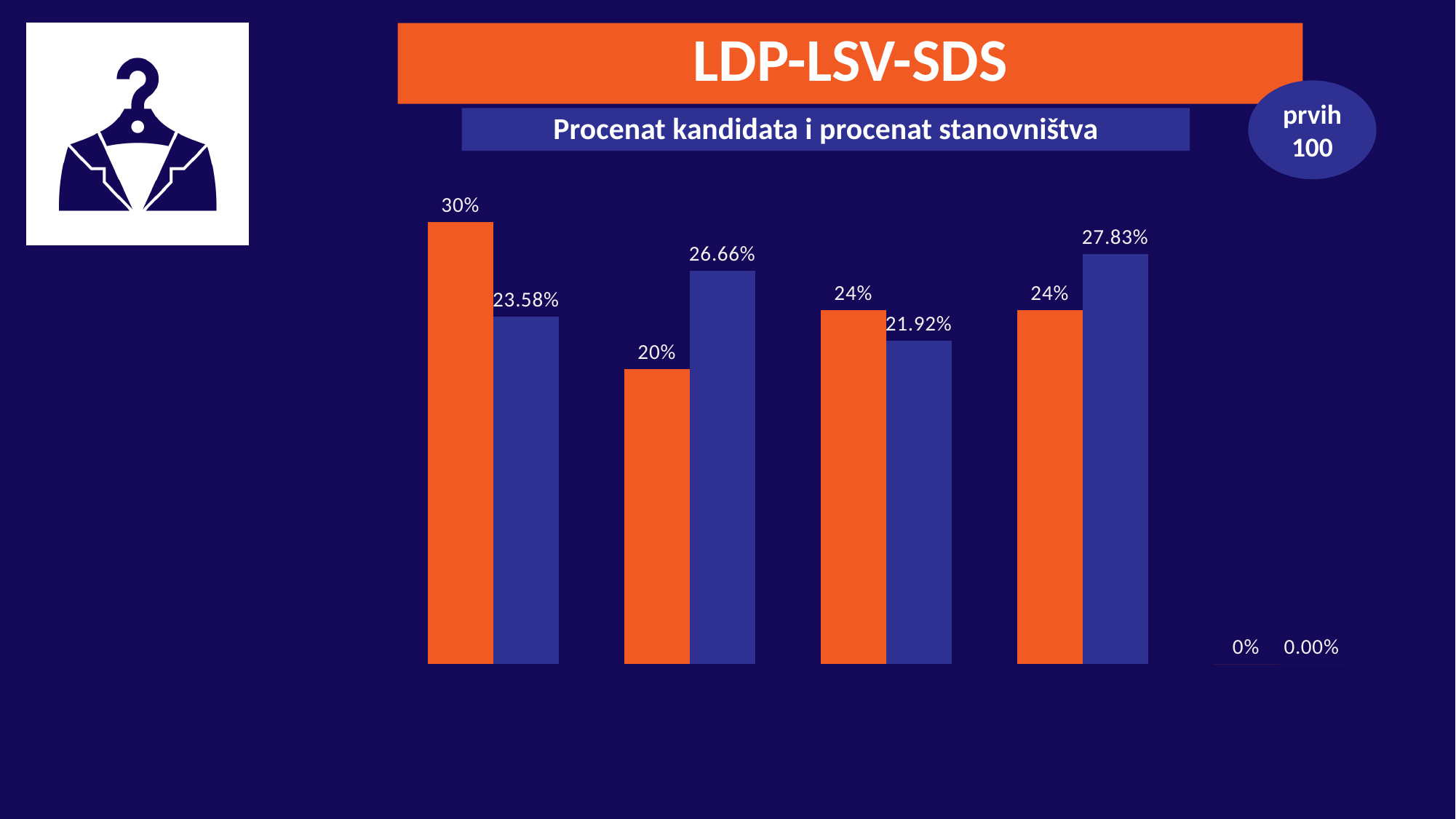
What kind of chart is shown on the slide? bar chart What is the value of the blue bar in the fourth group from the left? 27.83% What is the value of the orange bar in the first (leftmost) group? 30% How many orange bars have a value of 24%? 2 Which group has the tallest blue bar? the fourth group, 27.83% In the first group, what is the difference between the orange bar and the blue bar? 6.42% Which group has the tallest orange bar? the first (leftmost) group, 30% In the second group, which bar is larger, the orange or the blue? the blue bar (26.66%) Among the four groups with non-zero bars, which has the lowest orange bar? the second group, 20% What is the value of the blue bar in the third group from the left? 21.92% What is the value of the blue bar in the second group from the left? 26.66% What is the subtitle shown above the chart? Procenat kandidata i procenat stanovništva